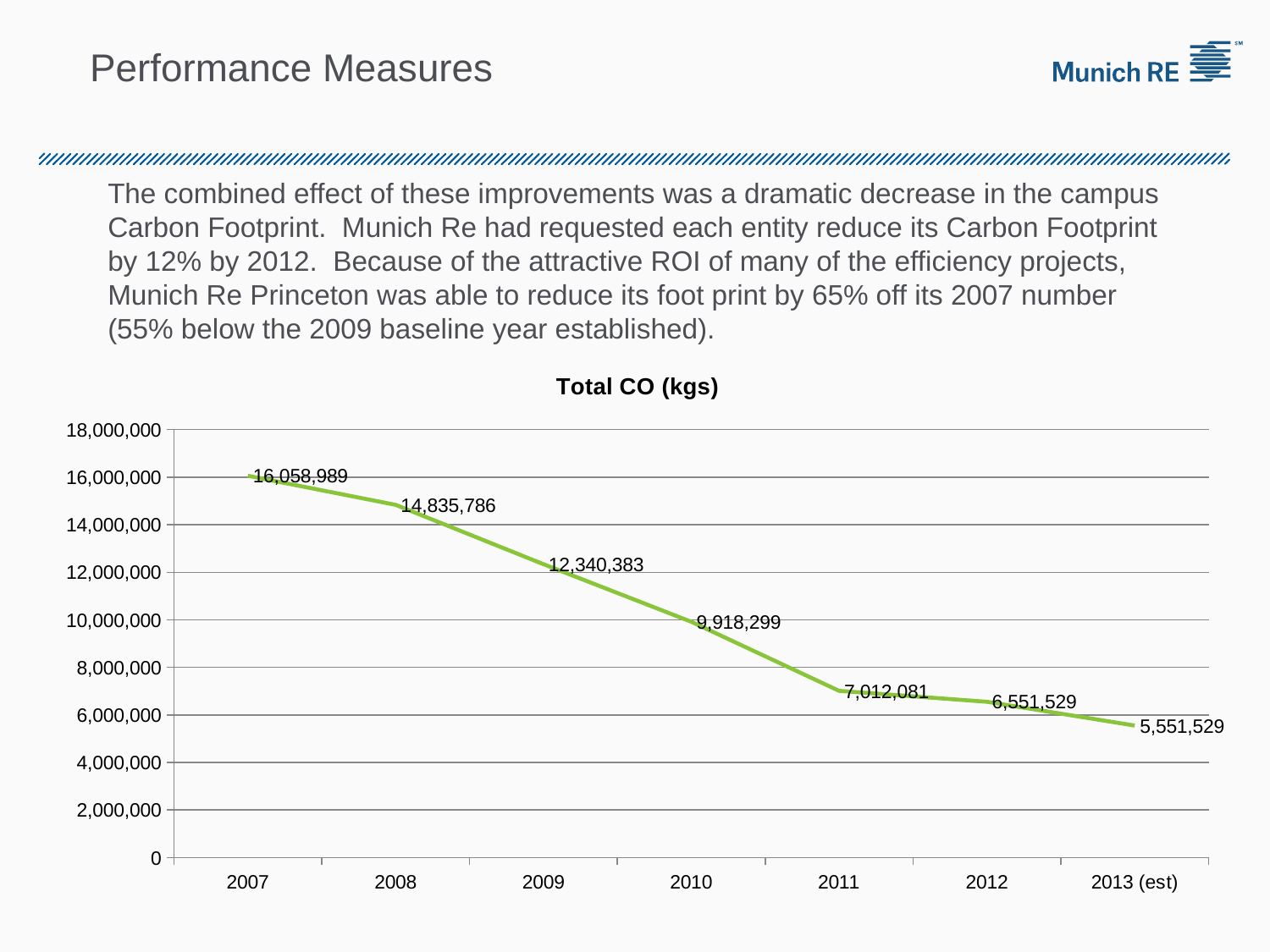
What is the Total CO (kgs) value for 2007? 16,058,989 Which year has the highest Total CO (kgs) value? 2007 Is the Total CO (kgs) value for 2011 greater or less than 8,000,000? less What is the Total CO (kgs) value for 2013 (est)? 5,551,529 Do the Total CO (kgs) values rise or fall from 2007 to 2013 (est)? fall How many years are plotted on the Total CO (kgs) chart? 7 Which year has the lowest Total CO (kgs) value? 2013 (est) What kind of chart is used to show Total CO (kgs)? line chart What is the difference between the Total CO (kgs) values for 2012 and 2013 (est)? 1,000,000 What is the difference between the Total CO (kgs) values for 2007 and 2008? 1,223,203 Which is larger, the Total CO (kgs) value for 2009 or for 2011? 2009 What is the Total CO (kgs) value for 2010? 9,918,299